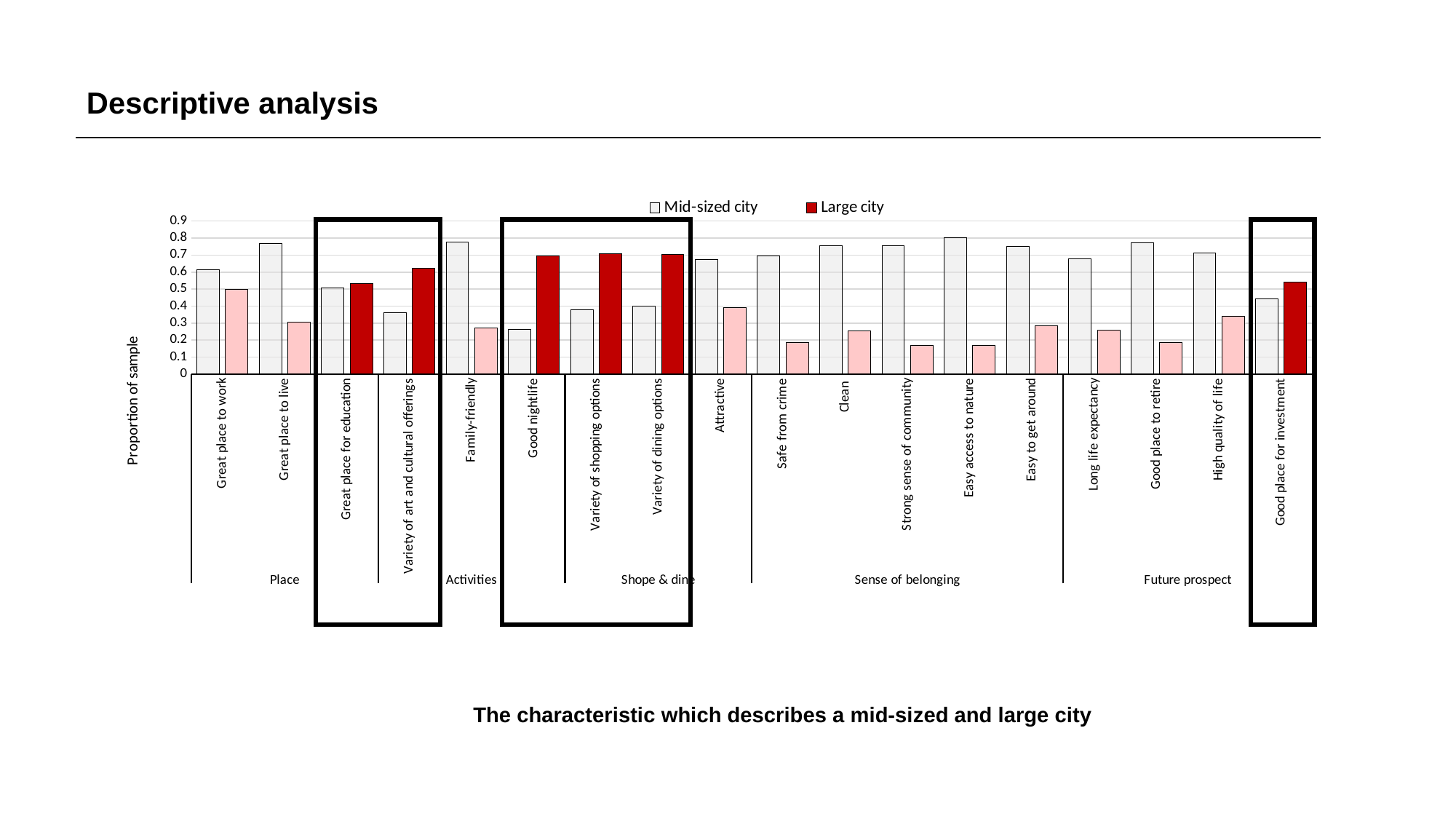
For Great place to live, which series has the larger value, Mid-sized city or Large city? Mid-sized city What is the label on the vertical axis? Proportion of sample What kind of chart is shown on the slide? bar chart Is the Large city value for Good place for investment greater or less than 0.5? greater How many series does the legend list? 2 Is the Mid-sized city value for Family-friendly greater or less than 0.7? greater Is the Mid-sized city value for Good nightlife greater or less than 0.3? less For Good nightlife, which series has the larger value, Mid-sized city or Large city? Large city Which characteristic has the lowest Mid-sized city value? Good nightlife Which series is shown with dark red bars? Large city How many characteristics (categories) are plotted along the x axis? 18